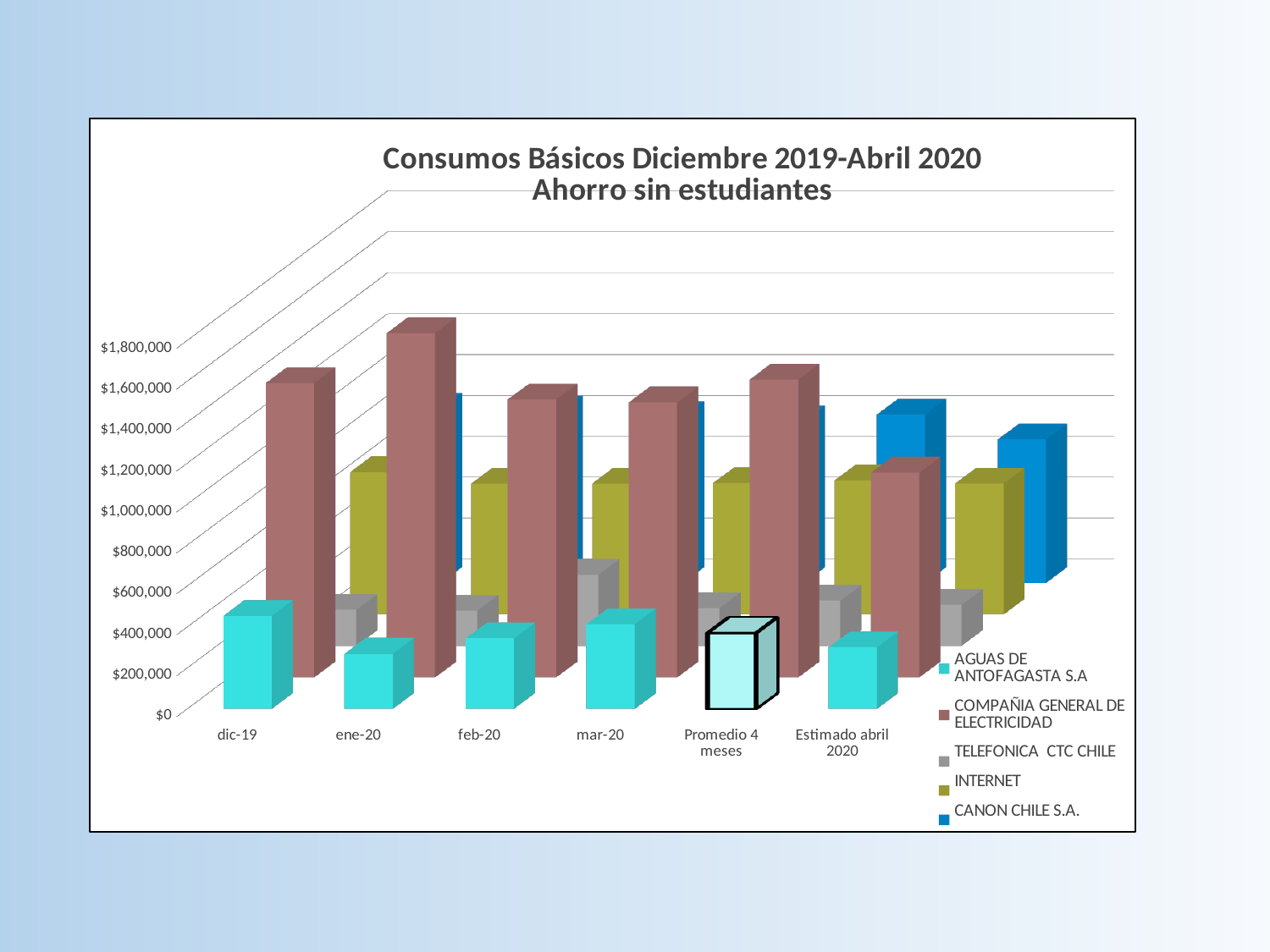
How many categories are shown along the x axis? 6 How many series does the legend list? 5 In mar-20, which is larger: the INTERNET bar or the TELEFONICA CTC CHILE bar? INTERNET Which series is shown in blue in the legend? CANON CHILE S.A. What kind of chart is shown on the slide? bar chart What is the title of the chart? Consumos Básicos Diciembre 2019-Abril 2020 Ahorro sin estudiantes In which category is the COMPAÑIA GENERAL DE ELECTRICIDAD bar the highest? ene-20 Which series has the tallest bar in the chart overall? COMPAÑIA GENERAL DE ELECTRICIDAD Is the value for AGUAS DE ANTOFAGASTA S.A in dic-19 greater or less than $1,000,000? less In dic-19, which is larger: the COMPAÑIA GENERAL DE ELECTRICIDAD bar or the AGUAS DE ANTOFAGASTA S.A bar? COMPAÑIA GENERAL DE ELECTRICIDAD Is the value for COMPAÑIA GENERAL DE ELECTRICIDAD in ene-20 greater or less than $1,000,000? greater In which category is the COMPAÑIA GENERAL DE ELECTRICIDAD bar the lowest? Estimado abril 2020